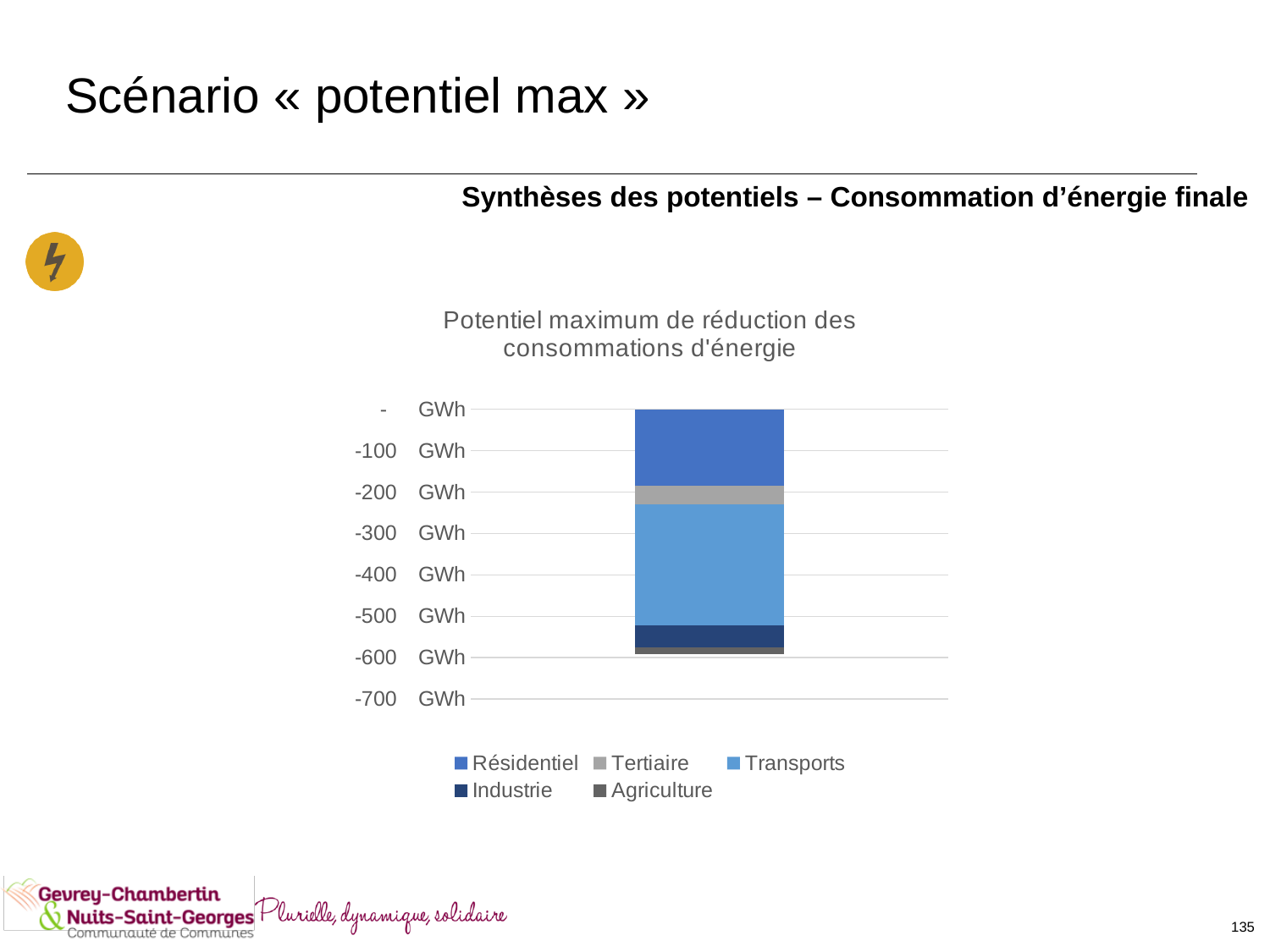
What is the title of the chart? Potentiel maximum de réduction des consommations d'énergie What unit is shown on the vertical axis of the chart? GWh Which segment is larger, Transports or Résidentiel? Transports How many series does the chart legend list? 5 What type of chart is shown on the slide? Stacked bar chart How many bars are plotted in the chart? 1 Which series occupies the smallest segment of the stacked bar? Agriculture Which series occupies the largest segment of the stacked bar? Transports Which segment is larger, Résidentiel or Tertiaire? Résidentiel Which series is listed first in the chart legend? Résidentiel Does the bottom of the stacked bar extend below the -500 GWh gridline? Yes